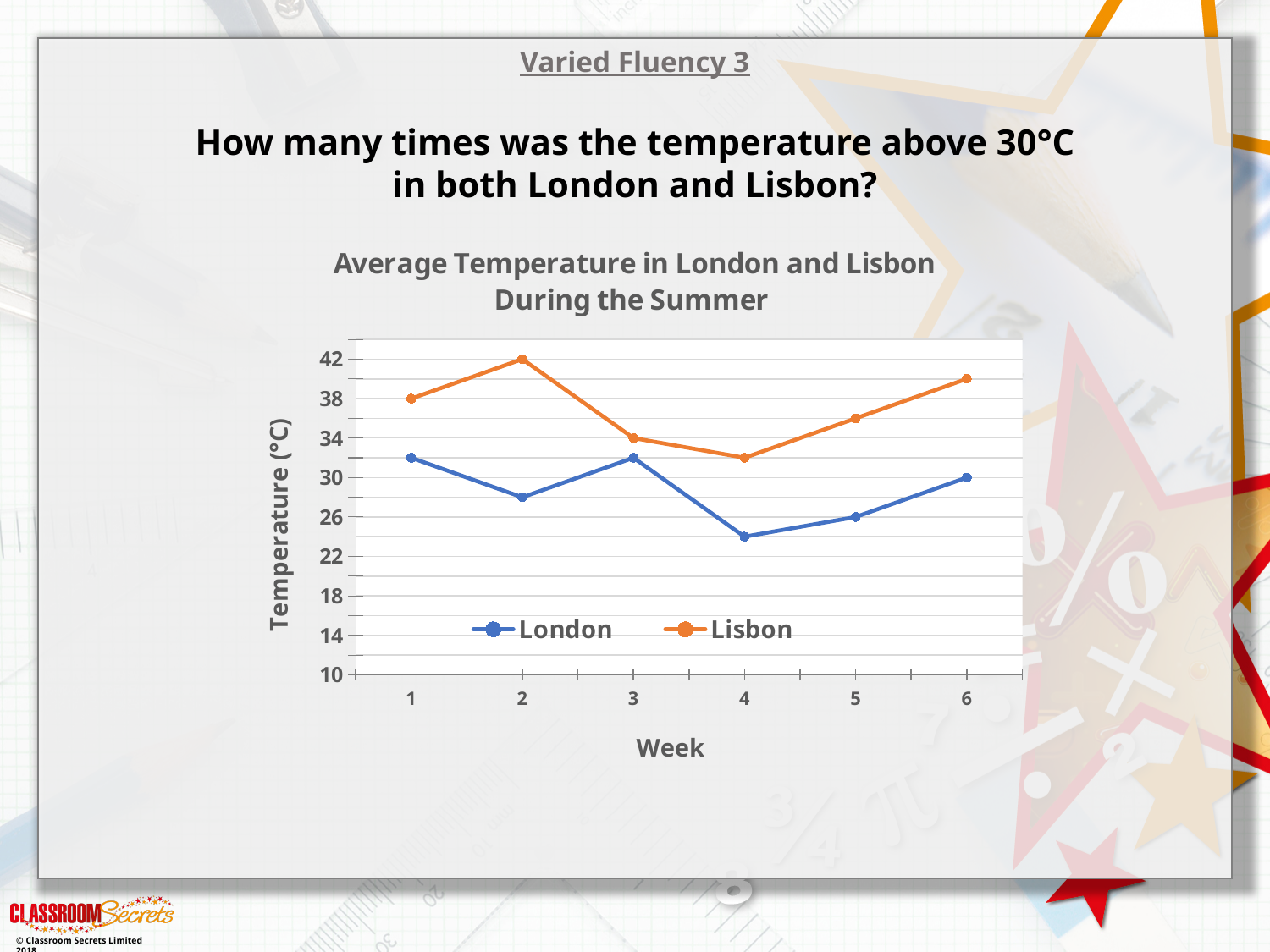
In which week was the Lisbon temperature highest? Week 2 In which week was the London temperature lowest? Week 4 What was the average temperature in Lisbon in week 2? 42 What was the average temperature in Lisbon in week 1? 38 Is the Lisbon temperature in week 6 greater or less than 38? greater Does the Lisbon temperature rise or fall from week 4 to week 6? rise What was the average temperature in London in week 6? 30 Is the London temperature in week 4 greater or less than 26? less How many series does the legend list? 2 What type of chart is shown on the slide? line chart How many weeks are plotted on the x axis? 6 What is the difference between the Lisbon temperature in week 2 and the London temperature in week 6? 12